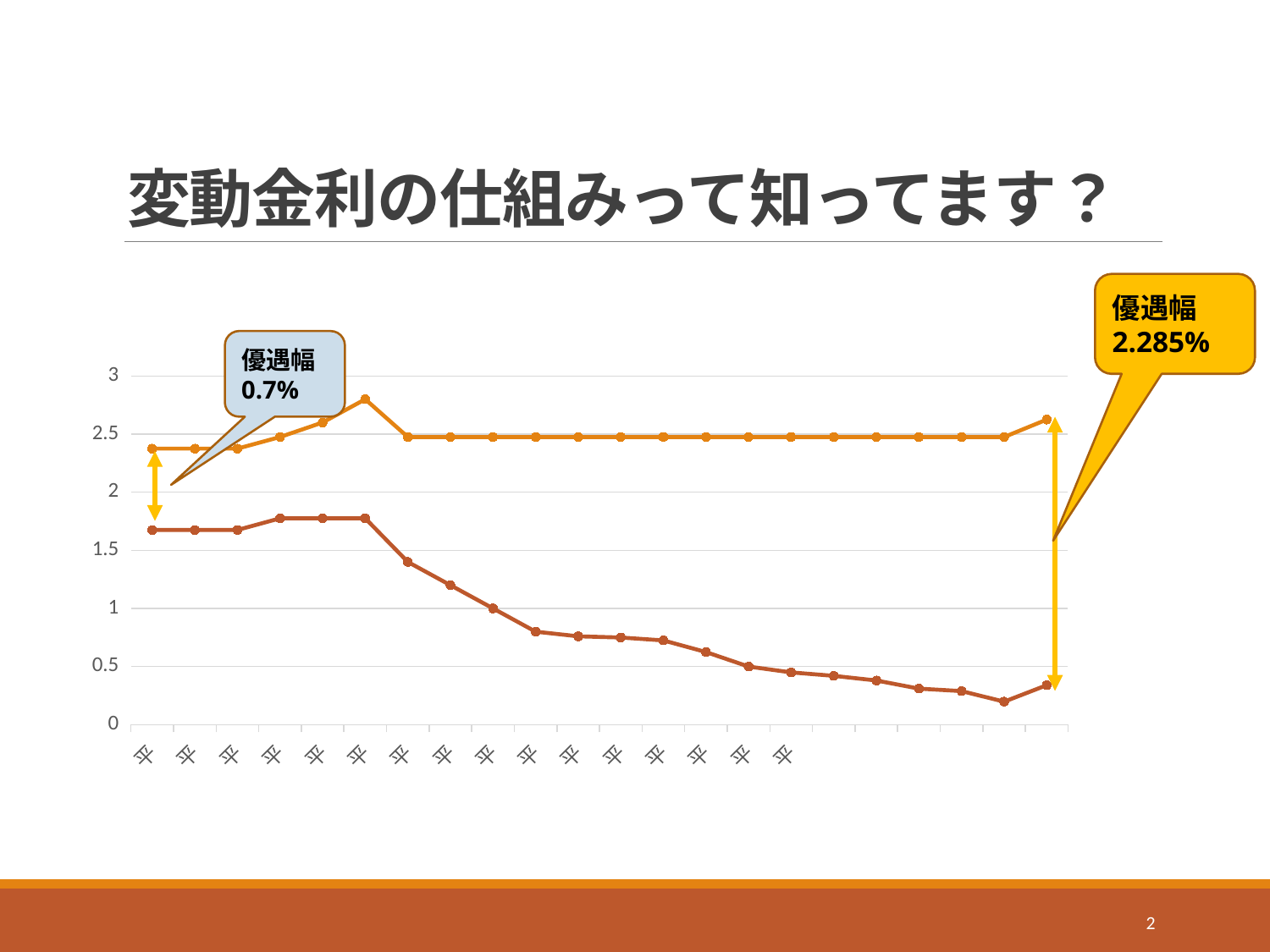
Is the last point of the lower (dark brown) line greater or less than 0.5? less Is the lowest point of the lower (dark brown) line greater or less than 0.5? less Is the highest point of the upper (orange) line greater or less than 2.5? greater Does the lower (dark brown) line generally rise or fall from left to right? fall What kind of chart is shown on the slide? line chart How many lines are plotted on the chart? 2 What 優遇幅 value is shown in the callout at the right end of the chart? 2.285% At the first point on the x axis, which line has the higher value, the upper orange line or the lower dark brown line? the upper orange line What is the highest value shown on the y axis? 3